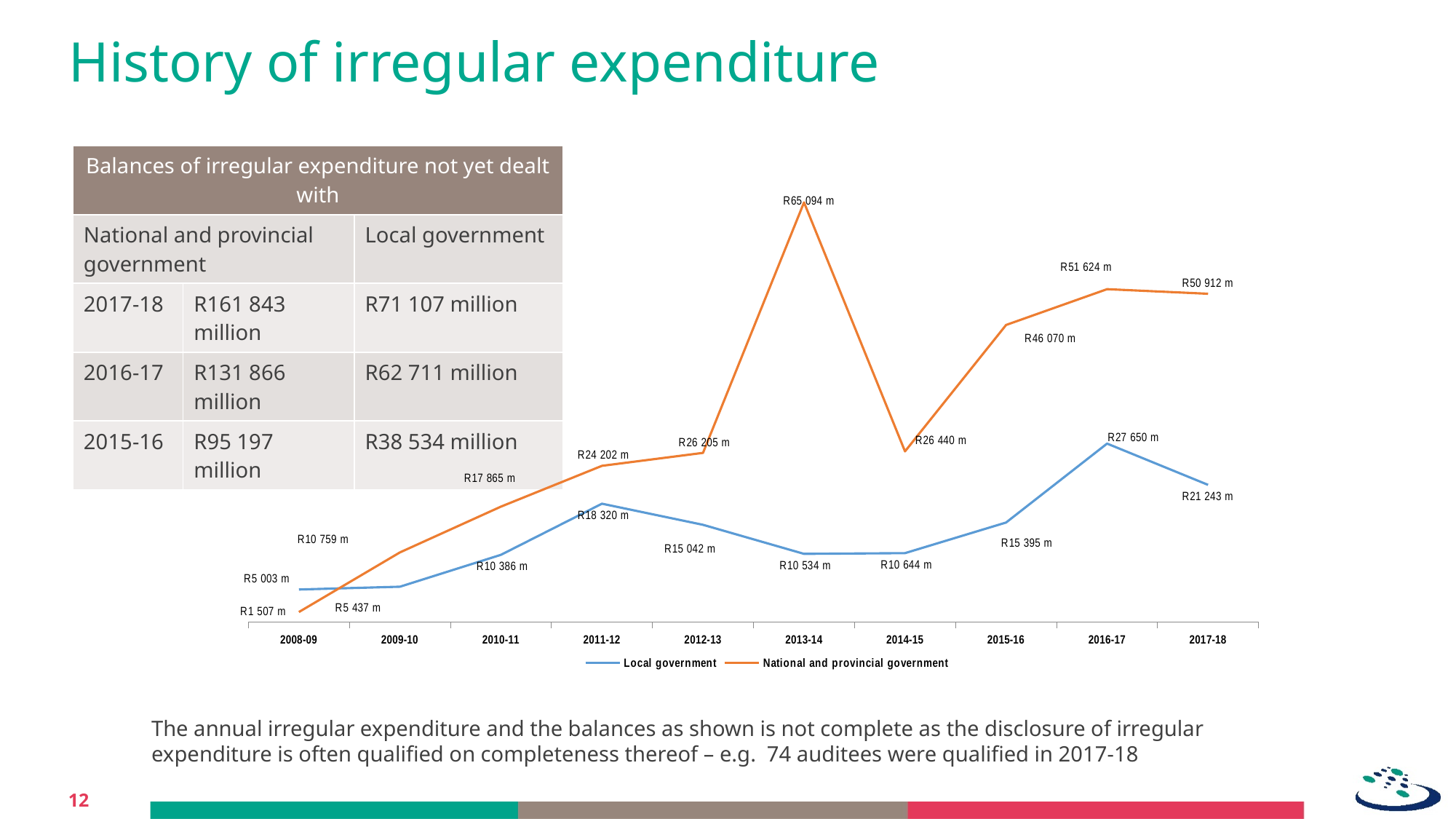
How many series does the chart legend list? 2 What type of chart is shown on the slide? line chart What is the value for Local government in 2016-17? R27 650 m In which year is the Local government value lowest? 2008-09 Which series has the larger value in 2008-09, Local government or National and provincial government? Local government What is the value for National and provincial government in 2013-14? R65 094 m In which year is the National and provincial government value highest? 2013-14 What is the difference between the National and provincial government value and the Local government value in 2017-18? R29 669 m What is the value for National and provincial government in 2008-09? R1 507 m What is the value for Local government in 2012-13? R15 042 m Does the Local government value rise or fall from 2016-17 to 2017-18? fall How many financial years are plotted along the x axis of the chart? 10